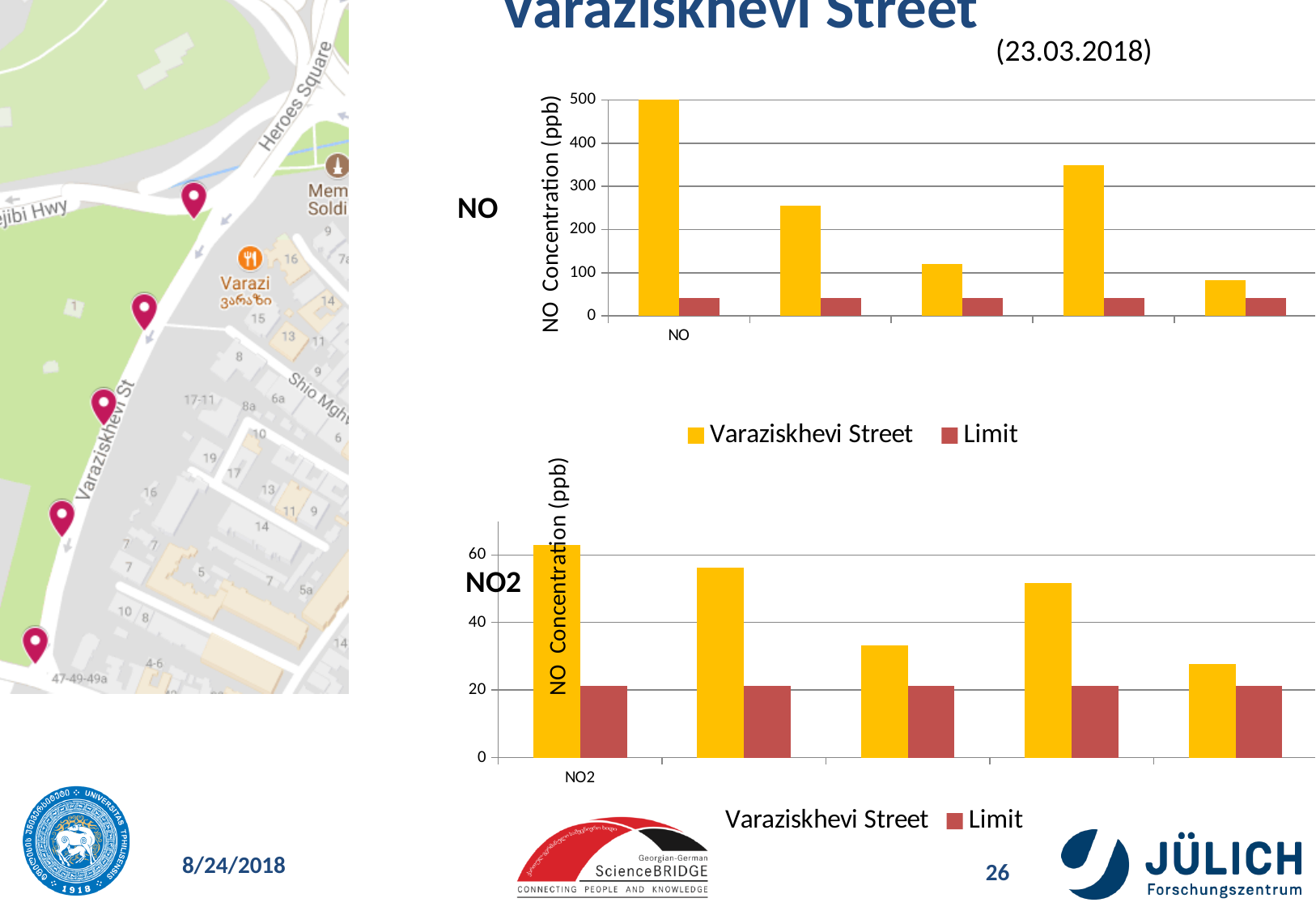
In the top NO chart, which is larger: the Varaziskhevi Street value for the second group or for the fourth group? the fourth group How many groups of bars are plotted in the bottom NO2 chart? 5 In the top NO chart, is the Varaziskhevi Street value for the first group greater or less than 400? greater In the bottom NO2 chart, which colour represents the Limit series? red In the top NO chart, is the Varaziskhevi Street value for the fourth group greater or less than 300? greater How many series does the legend of the NO chart list? 2 In the top NO chart, which group of bars has the lowest Varaziskhevi Street value? the fifth group What kind of chart is the top NO chart? bar chart In the bottom NO2 chart, which group of bars has the highest Varaziskhevi Street value? the first group In the top NO chart, is the Varaziskhevi Street value for the fifth group greater or less than 100? less In the top NO chart, which group of bars has the highest Varaziskhevi Street value? the first group